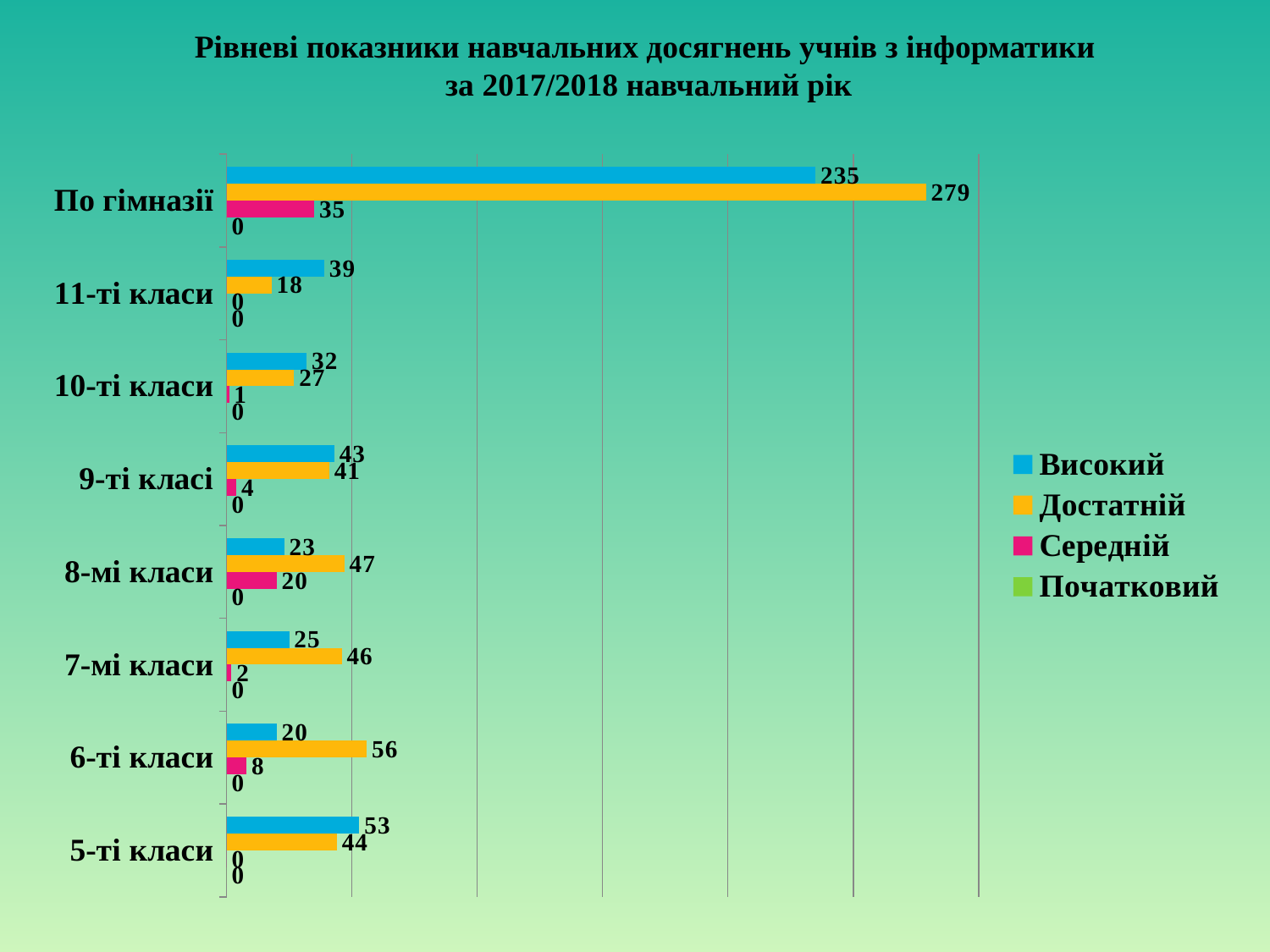
What is the value of Достатній for По гімназії? 279 Which series is shown in pink/magenta in the legend? Середній What is the difference between the Достатній and Високий values for По гімназії? 44 How many series does the legend list? 4 What is the value of Достатній for 11-ті класи? 18 Among the class groups (excluding По гімназії), which category has the lowest Достатній value? 11-ті класи Which is larger for 9-ті класі: Високий or Достатній? Високий What kind of chart is shown on the slide? Bar chart Among the class groups (excluding По гімназії), which category has the highest Достатній value? 6-ті класи What is the value of Середній for 8-мі класи? 20 How many categories are shown on the y axis? 8 What is the value of Високий for 5-ті класи? 53